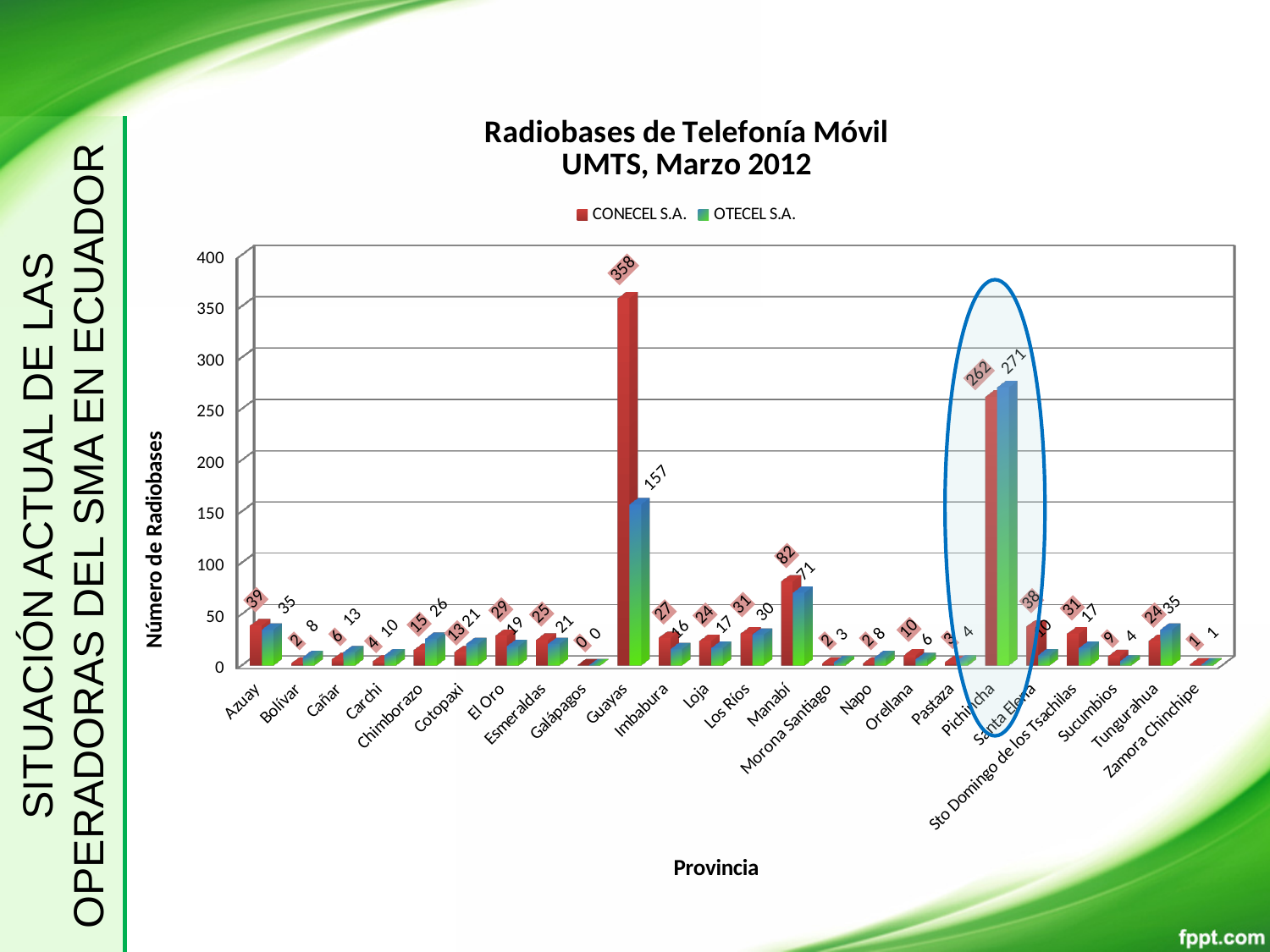
In Manabí, which series has the larger value, CONECEL S.A. or OTECEL S.A.? CONECEL S.A. How many radiobases does OTECEL S.A. have in Azuay? 35 Which province has the highest value for OTECEL S.A.? Pichincha What is the title of the x axis? Provincia What kind of chart is shown on the slide? bar chart How many radiobases does CONECEL S.A. have in Guayas? 358 What is the difference between the CONECEL S.A. and OTECEL S.A. values in Guayas? 201 What is the difference between the OTECEL S.A. and CONECEL S.A. values in Pichincha? 9 How many provinces are shown on the x axis? 24 How many radiobases does OTECEL S.A. have in Pichincha? 271 Which province has the highest value for CONECEL S.A.? Guayas How many series does the legend list? 2